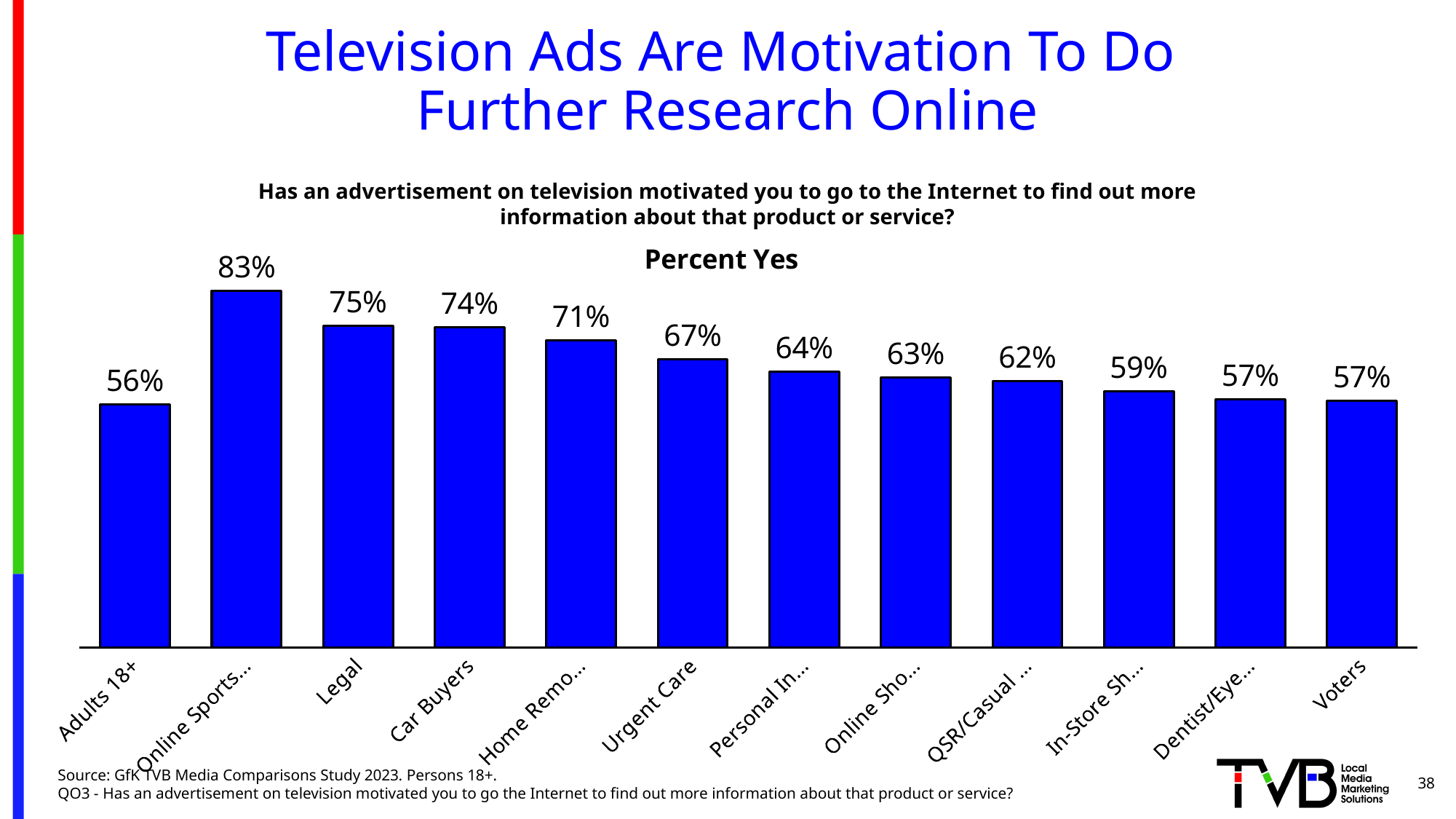
Which is larger, the value for Legal or the value for Car Buyers? Legal What is the difference between the values for Car Buyers and Voters? 17 percentage points What is the value for Urgent Care? 67% Which category has the highest value? Online Sports Which category has the lowest value? Adults 18+ What is the value for Voters? 57% How many categories are shown in the chart? 12 What is the value for Car Buyers? 74% What is the value for Legal? 75% What is the value for Adults 18+? 56% What kind of chart is shown on the slide? Bar chart What is the difference between the values for Legal and Adults 18+? 19 percentage points